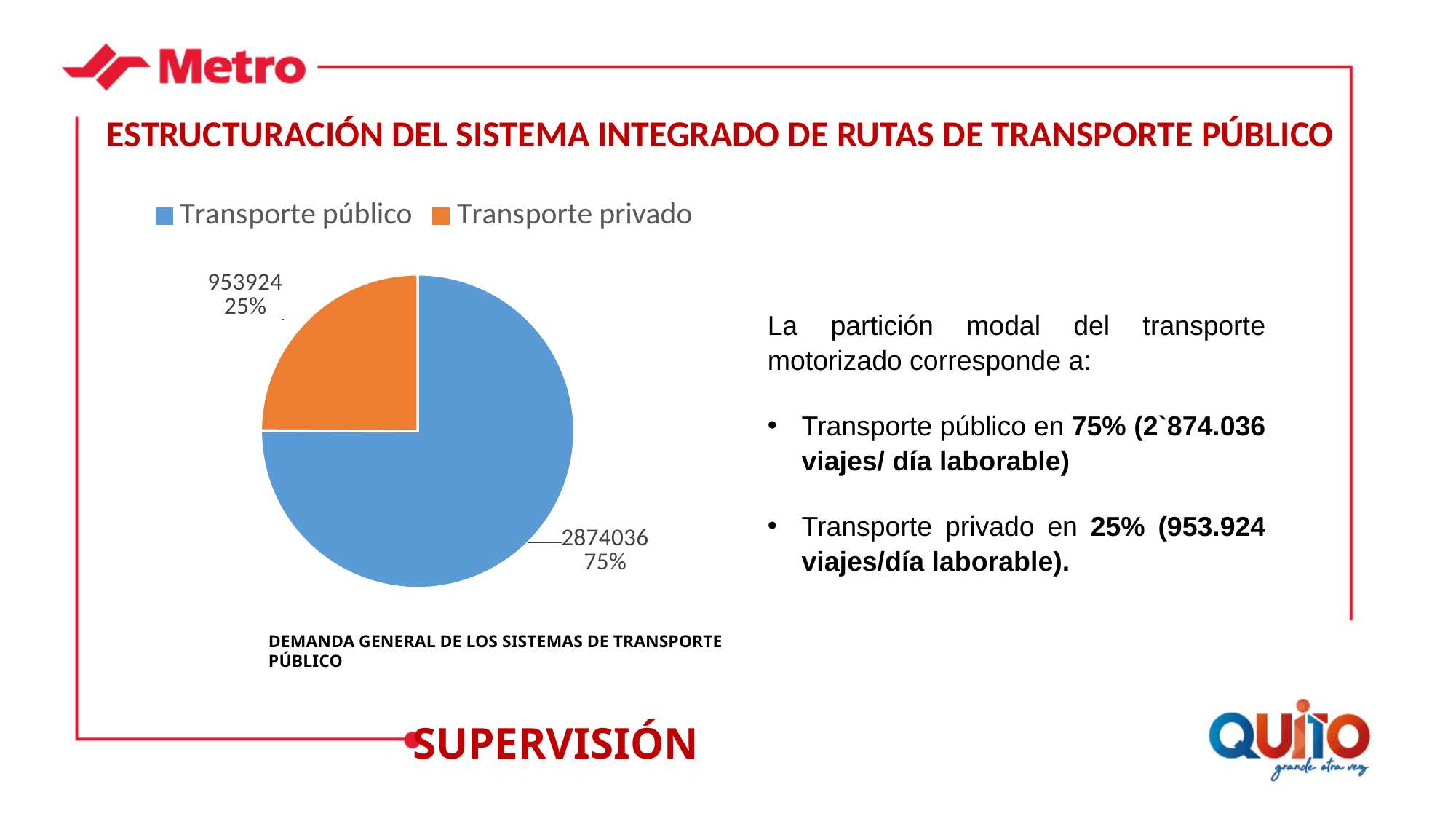
Which category has the smallest slice in the pie chart? Transporte privado How many entries does the legend list? 2 Which is larger, the value for Transporte público or Transporte privado? Transporte público What colour is the Transporte privado slice? Orange What share of the pie does Transporte privado represent? 25% What kind of chart is shown on the slide? Pie chart What is the value for Transporte público in the pie chart? 2874036 What is the difference between the values for Transporte público and Transporte privado? 1920112 What share of the pie does Transporte público represent? 75% Which category has the largest slice in the pie chart? Transporte público How many slices does the pie chart have? 2 What is the value for Transporte privado in the pie chart? 953924